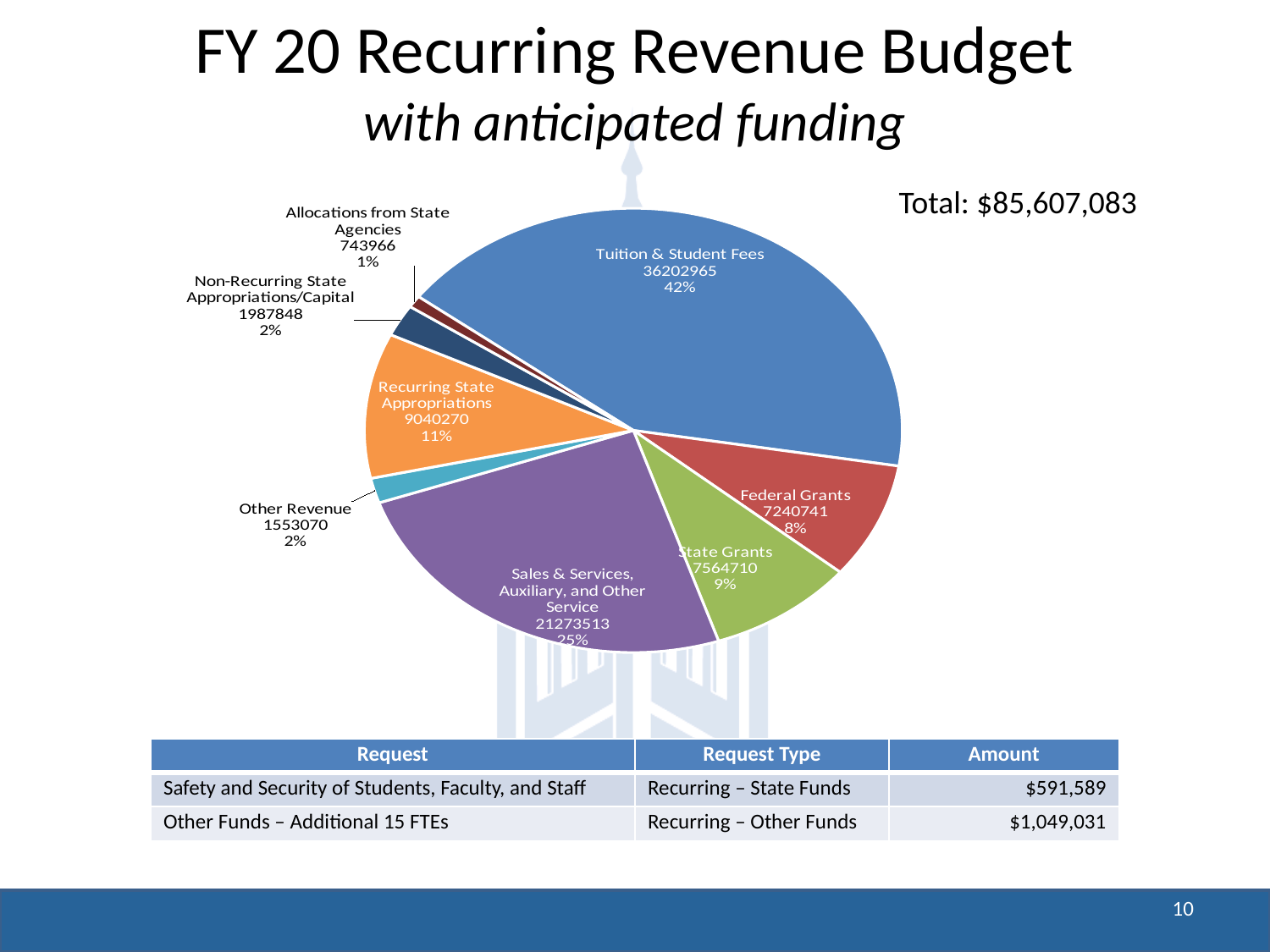
What kind of chart is shown on the slide? Pie chart Which is larger, State Grants or Federal Grants? State Grants What is the difference between the values for State Grants and Federal Grants? 323969 What is the value for Non-Recurring State Appropriations/Capital? 1987848 How many categories are shown in the pie chart? 8 What share of the pie does Sales & Services, Auxiliary, and Other Service represent? 25% What is the value for Recurring State Appropriations? 9040270 What total is stated next to the pie chart? $85,607,083 Which category has the largest slice of the pie? Tuition & Student Fees Which category has the smallest slice of the pie? Allocations from State Agencies What percentage of the pie is Federal Grants? 8% What is the value for Tuition & Student Fees in the pie chart? 36202965